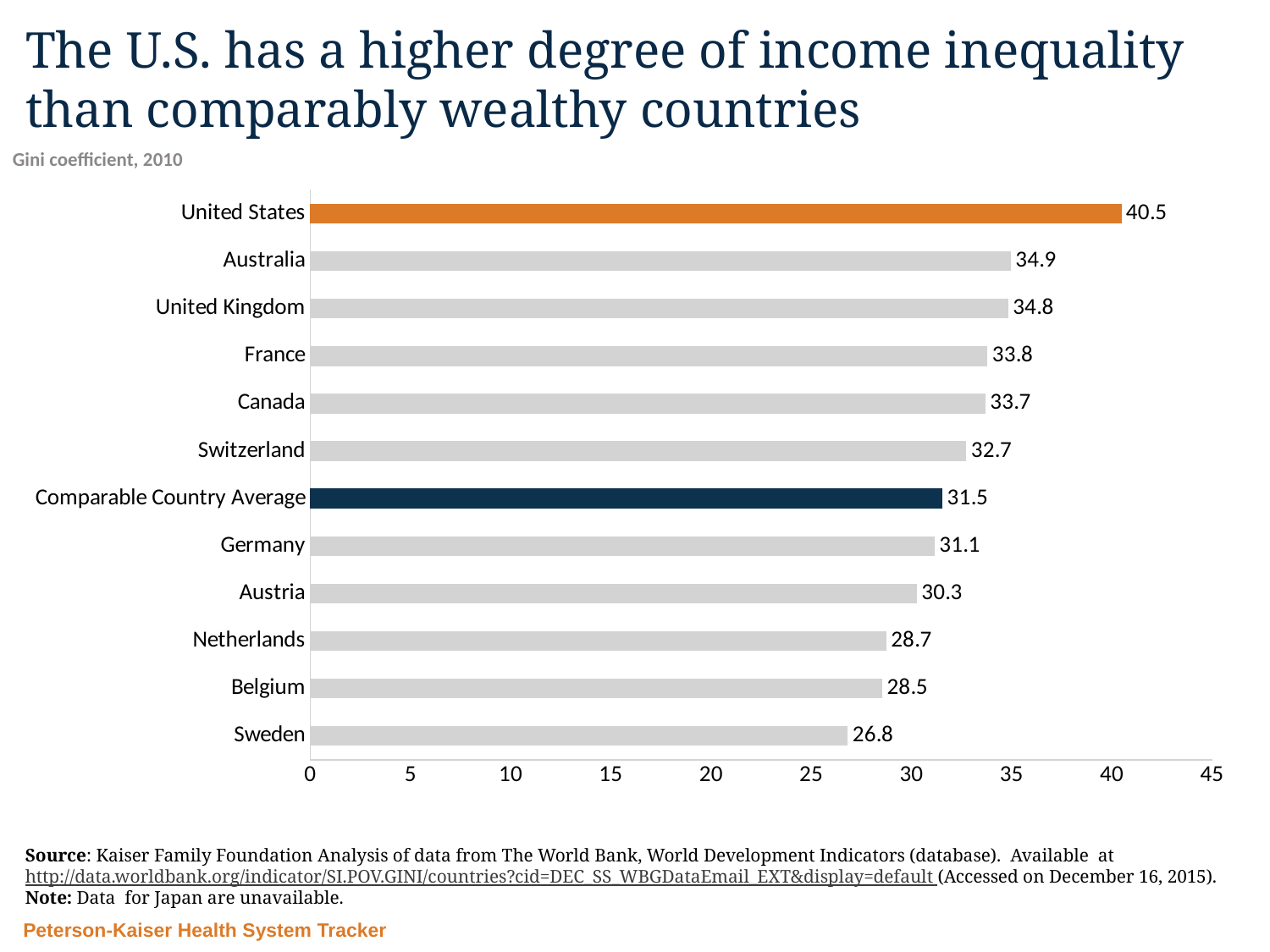
Which country has the highest Gini coefficient on the chart? United States What is the difference between the values for Australia and Sweden? 8.1 What is the subtitle printed above the chart? Gini coefficient, 2010 Which has a higher Gini coefficient, Germany or Switzerland? Switzerland What is the Gini coefficient shown for Sweden? 26.8 What is the difference between the Gini coefficient for the United States and the Comparable Country Average? 9.0 Which country has the lowest Gini coefficient on the chart? Sweden What is the Gini coefficient shown for the United States? 40.5 What is the value shown for the Comparable Country Average? 31.5 What kind of chart is shown on the slide? Bar chart Is the value for Canada greater or less than 30? greater How many bars are shown on the chart? 12